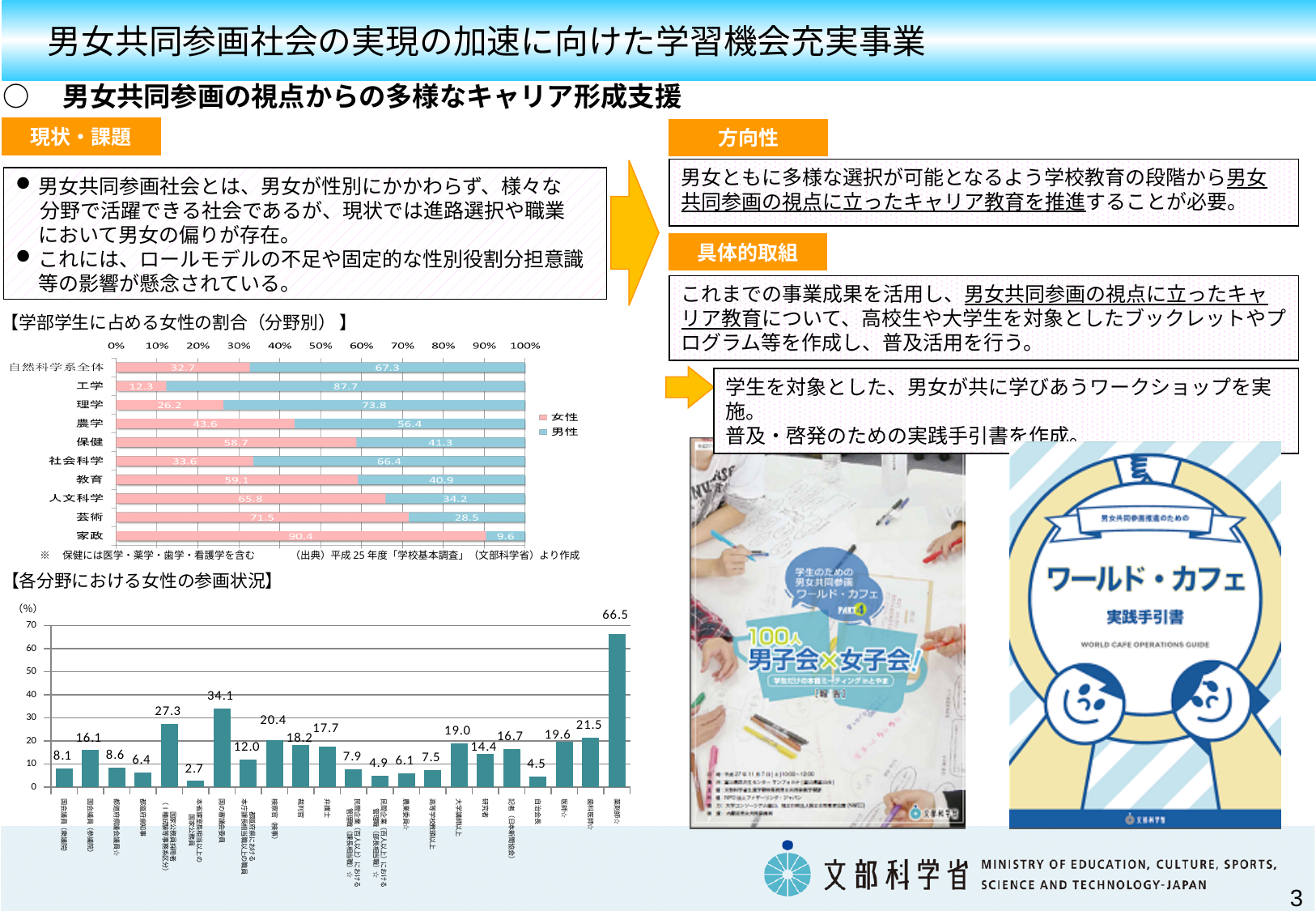
In the chart 【学部学生に占める女性の割合（分野別）】, what is the value for 男性 in 家政? 9.6 In the chart 【学部学生に占める女性の割合（分野別）】, which category has the highest 女性 value? 家政 In the chart 【学部学生に占める女性の割合（分野別）】, how many categories are shown? 10 In the chart 【学部学生に占める女性の割合（分野別）】, how many series does the legend list? 2 In the chart 【学部学生に占める女性の割合（分野別）】, which is larger: the 女性 value for 保健 or the 女性 value for 教育? 教育 In the chart 【学部学生に占める女性の割合（分野別）】, which category has the lowest 女性 value? 工学 In the chart 【各分野における女性の参画状況】, what is the value for 国会議員（衆議院）? 8.1 In the chart 【学部学生に占める女性の割合（分野別）】, what is the difference between the 男性 and 女性 values for 自然科学系全体? 34.6 In the chart 【各分野における女性の参画状況】, what is the lowest value shown? 2.7 What kind of chart is 【学部学生に占める女性の割合（分野別）】? Stacked horizontal bar chart In the chart 【各分野における女性の参画状況】, what is the highest value shown? 66.5 In the chart 【学部学生に占める女性の割合（分野別）】, what is the value for 女性 in 工学? 12.3